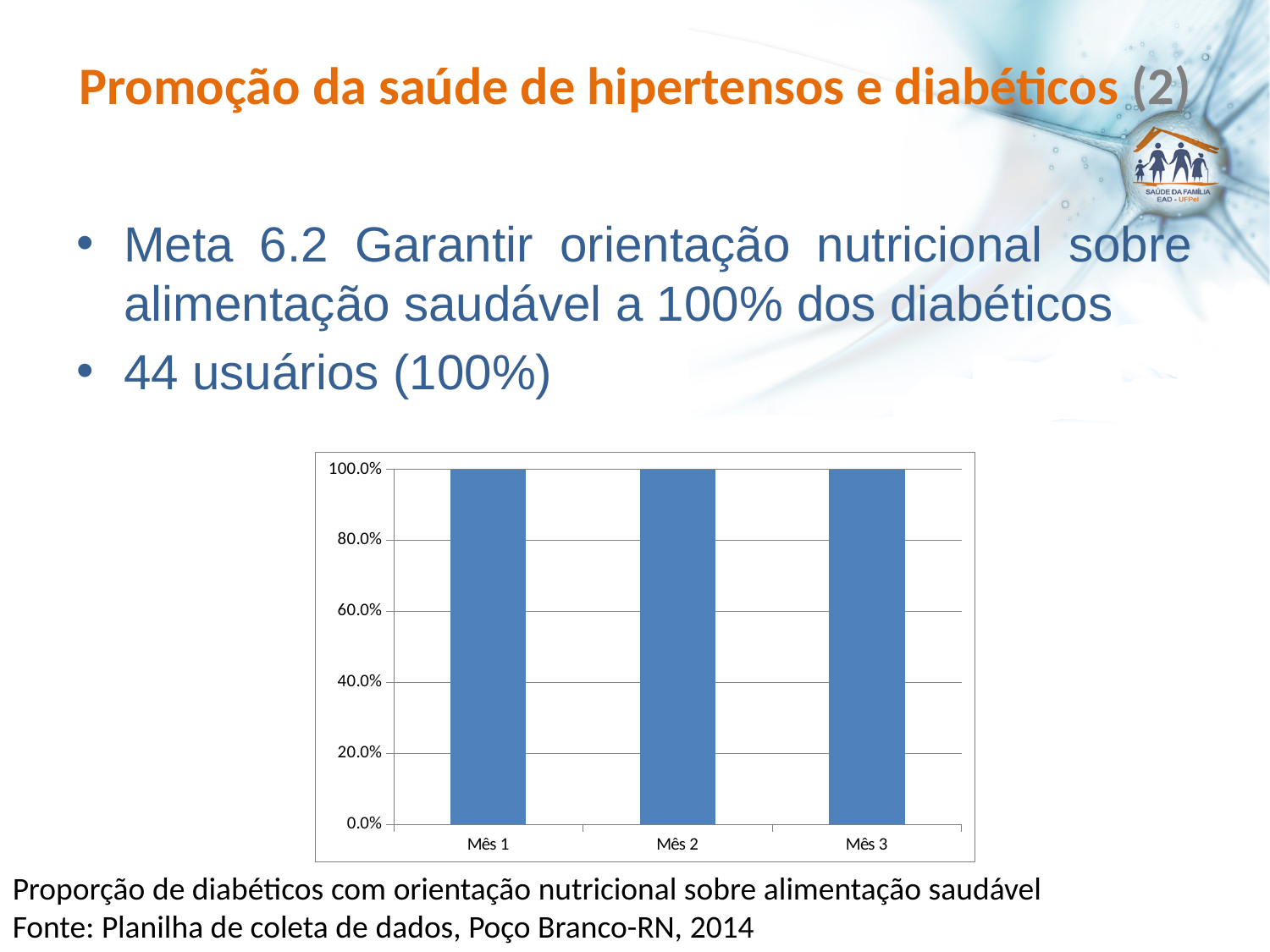
What is the difference between the values for Mês 1 and Mês 3? 0.0% What is the value for Mês 1 in the chart? 100.0% Do the values rise, fall, or stay the same from Mês 1 to Mês 3? stay the same What is the value for Mês 2 in the chart? 100.0% What kind of chart is shown on the slide? bar chart What is the highest value shown on the y axis of the chart? 100.0% How many categories are plotted on the x axis of the chart? 3 Is the value for Mês 2 greater or less than 80.0%? greater Is the value for Mês 3 greater or less than 60.0%? greater What is the value for Mês 3 in the chart? 100.0% What is the label of the first category on the x axis? Mês 1